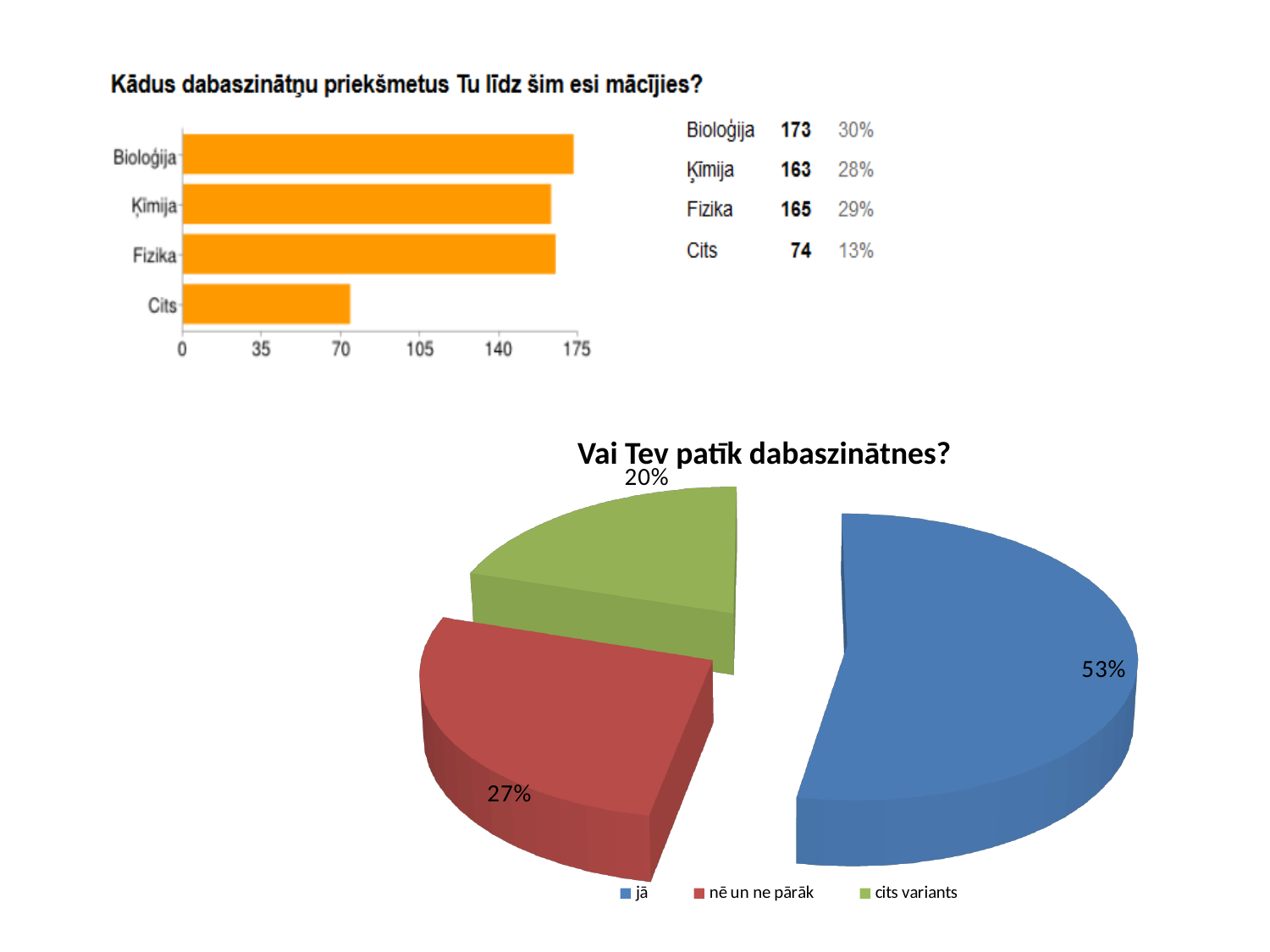
In the pie chart 'Vai Tev patīk dabaszinātnes?', what share does 'jā' have? 53% In the bar chart 'Kādus dabaszinātņu priekšmetus Tu līdz šim esi mācījies?', which category has the lowest value? Cits How many categories does the bar chart 'Kādus dabaszinātņu priekšmetus Tu līdz šim esi mācījies?' show? 4 What kind of chart is the chart titled 'Kādus dabaszinātņu priekšmetus Tu līdz šim esi mācījies?'? bar chart In the bar chart 'Kādus dabaszinātņu priekšmetus Tu līdz šim esi mācījies?', which category has the highest value? Bioloģija In the bar chart 'Kādus dabaszinātņu priekšmetus Tu līdz šim esi mācījies?', what percentage is shown for Fizika? 29% In the bar chart 'Kādus dabaszinātņu priekšmetus Tu līdz šim esi mācījies?', what is the value for Cits? 74 In the bar chart 'Kādus dabaszinātņu priekšmetus Tu līdz šim esi mācījies?', what is the difference between the values for Bioloģija and Cits? 99 In the pie chart 'Vai Tev patīk dabaszinātnes?', which slice is the smallest? cits variants In the bar chart 'Kādus dabaszinātņu priekšmetus Tu līdz šim esi mācījies?', is the value for Cits greater or less than 105? less How many entries does the legend of the pie chart 'Vai Tev patīk dabaszinātnes?' list? 3 In the bar chart 'Kādus dabaszinātņu priekšmetus Tu līdz šim esi mācījies?', what is the value for Bioloģija? 173